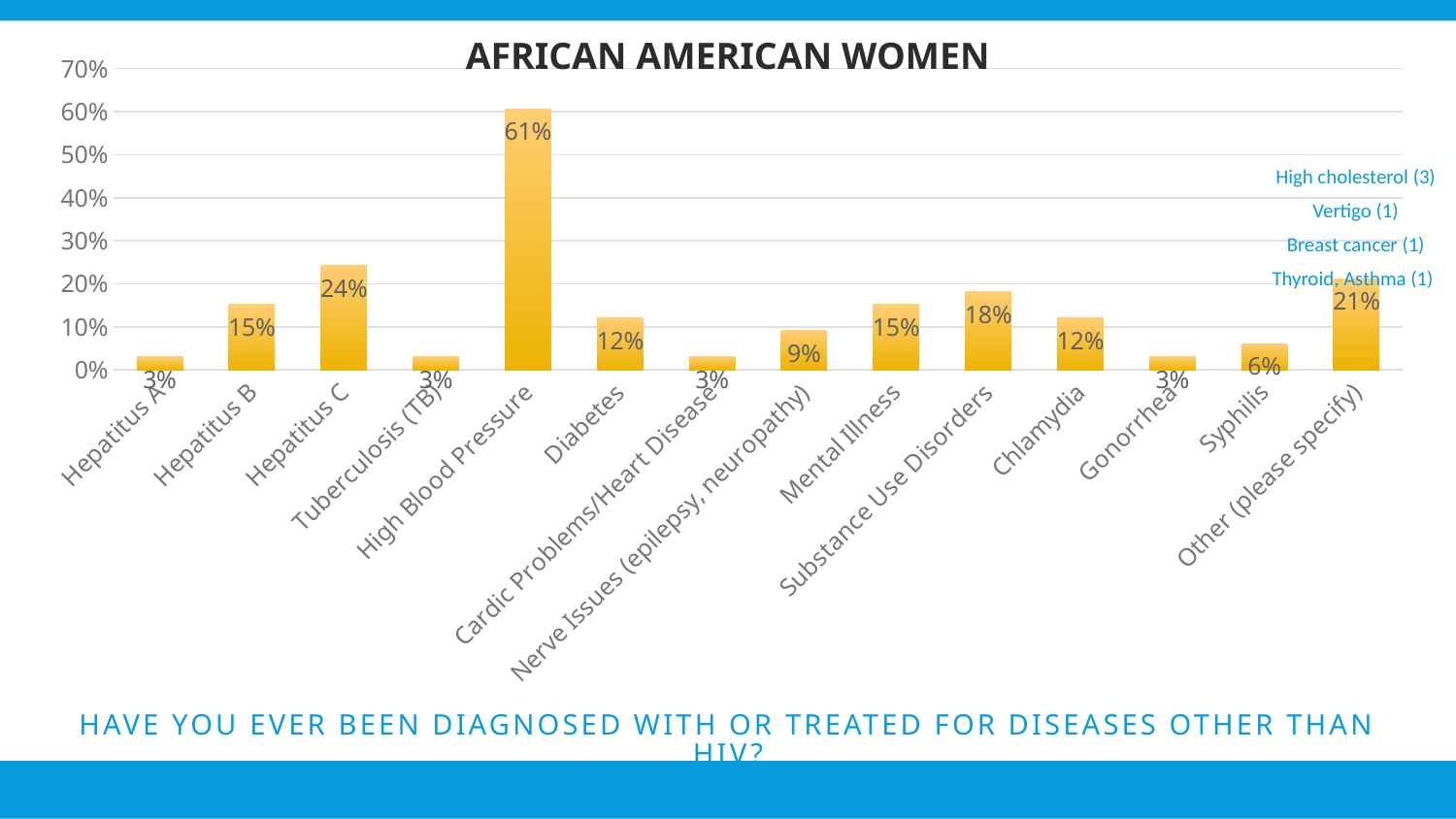
Is the value for Nerve Issues (epilepsy, neuropathy) greater or less than 10%? less What is the title of the chart? AFRICAN AMERICAN WOMEN How many categories are shown on the x axis? 14 Which is larger, the value for Mental Illness or the value for Diabetes? Mental Illness What is the value for Syphilis? 6% What is the difference between the values for High Blood Pressure and Hepatitus C? 37% What is the value for High Blood Pressure? 61% What is the value for Substance Use Disorders? 18% Which category has the highest value? High Blood Pressure What is the difference between the values for Other (please specify) and Substance Use Disorders? 3% What is the value for Hepatitus C? 24% What kind of chart is shown on the slide? bar chart